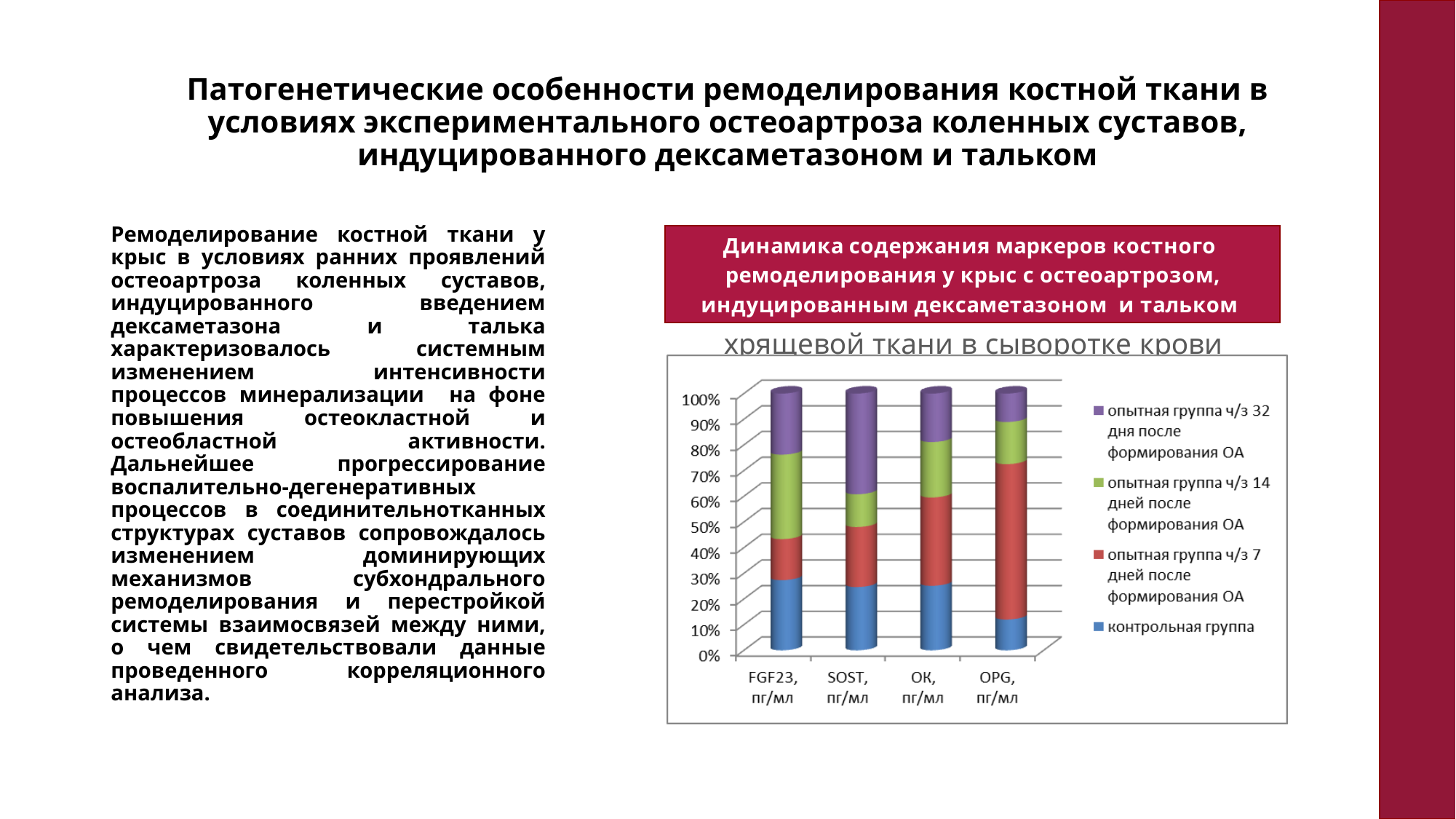
Which category has the largest segment for опытная группа ч/з 32 дня после формирования ОА? SOST, пг/мл Is the share of the контрольная группа segment for FGF23, пг/мл greater or less than 20%? greater What kind of chart is shown on the slide? Stacked bar chart Which category has the smallest segment for контрольная группа? OPG, пг/мл What is the total height of the stacked bar for SOST, пг/мл? 100% How many series does the chart legend list? 4 Which series is shown in blue in the chart legend? контрольная группа Is the share of the контрольная группа segment for OPG, пг/мл greater or less than 20%? less Which category has the largest segment for опытная группа ч/з 14 дней после формирования ОА? FGF23, пг/мл Which category has the largest segment for опытная группа ч/з 7 дней после формирования ОА? OPG, пг/мл How many categories are shown on the x axis of the chart? 4 Which series is shown in purple in the chart legend? опытная группа ч/з 32 дня после формирования ОА